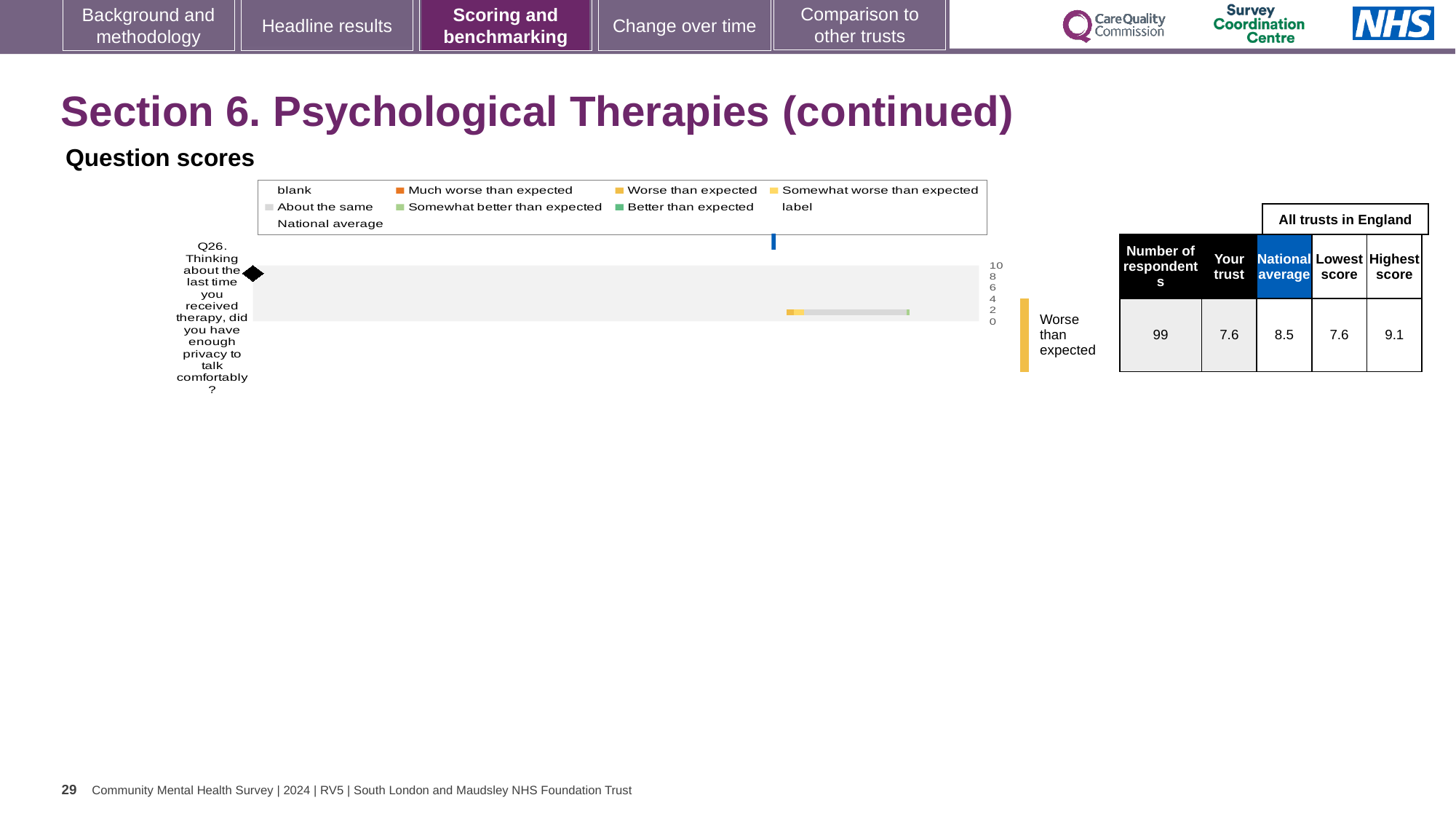
How many survey questions are plotted in the question scores chart? 1 How many respondents answered Q26? 99 What is the national average score for Q26 shown next to the chart? 8.5 What kind of chart is used to show the question scores on this slide? bar chart Which is larger for Q26, the 'Your trust' score or the national average? National average What is the 'Your trust' score for Q26 shown next to the chart? 7.6 What is the difference between the national average and the 'Your trust' score for Q26? 0.9 What benchmark category is shown for Q26 in the question scores chart? Worse than expected Which question is plotted in the question scores chart? Q26 What is the maximum value shown on the score axis of the question scores chart? 10 What is the highest score among all trusts in England for Q26? 9.1 What is the lowest score among all trusts in England for Q26? 7.6